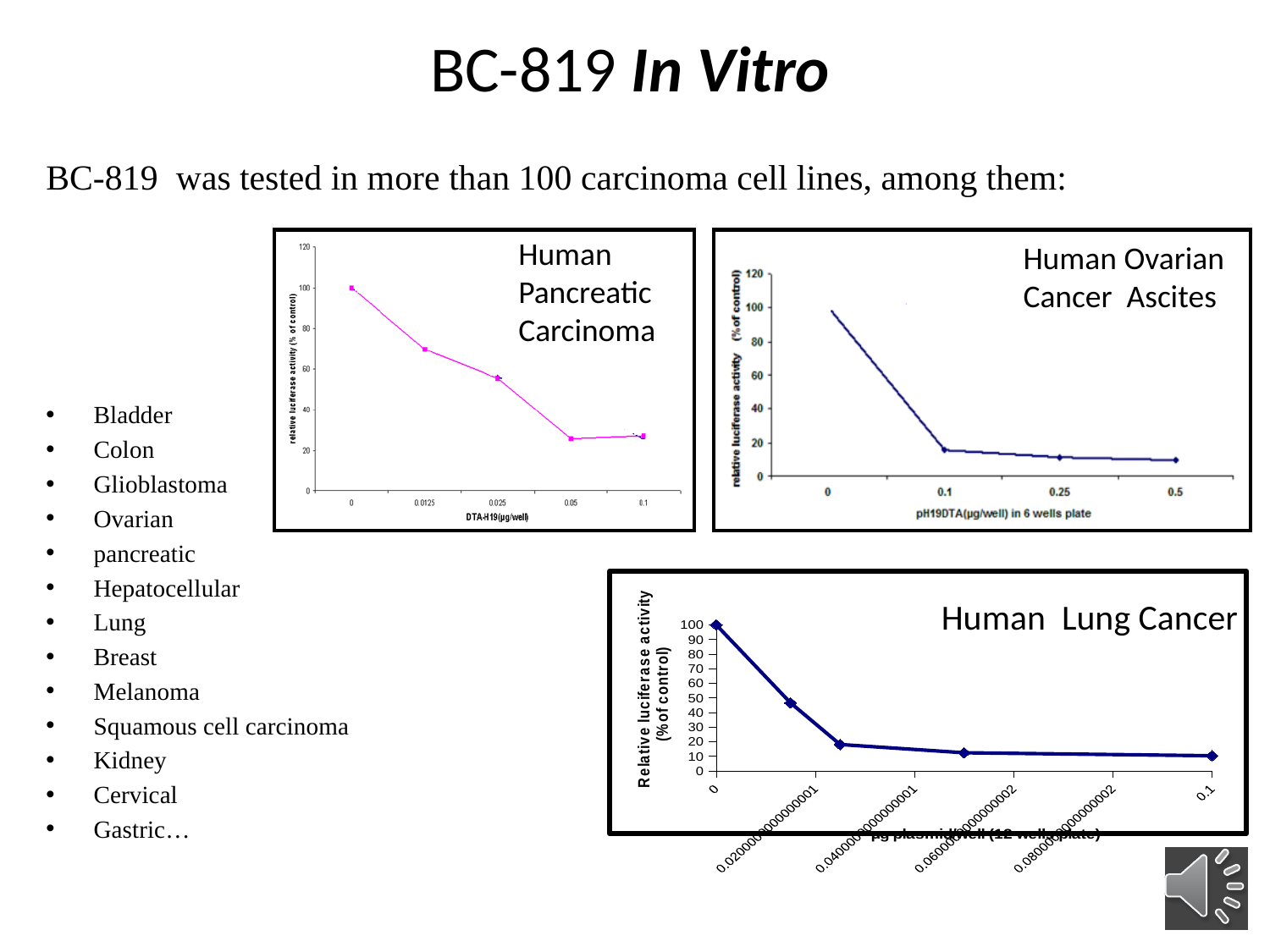
In the Human Ovarian Cancer Ascites chart, is the value at 0.1 µg/well greater or less than 20? less In the Human Ovarian Cancer Ascites chart, at which concentration is the relative luciferase activity highest? 0 In the Human Pancreatic Carcinoma chart, is the value at 0.05 µg/well greater or less than 40? less In the Human Pancreatic Carcinoma chart, how many data points are plotted? 5 In the Human Lung Cancer chart, is the value at 0.1 µg plasmid/well greater or less than 30? less In the Human Pancreatic Carcinoma chart, what is the relative luciferase activity at DTA-H19 concentration 0? 100 In the Human Lung Cancer chart, what is the relative luciferase activity at 0 µg plasmid/well? 100 How many charts are shown on the slide? 3 In the Human Ovarian Cancer Ascites chart, how many data points are plotted? 4 In the Human Ovarian Cancer Ascites chart, do the values rise or fall as the pH19DTA concentration increases? fall What kind of chart is the Human Pancreatic Carcinoma chart? line chart